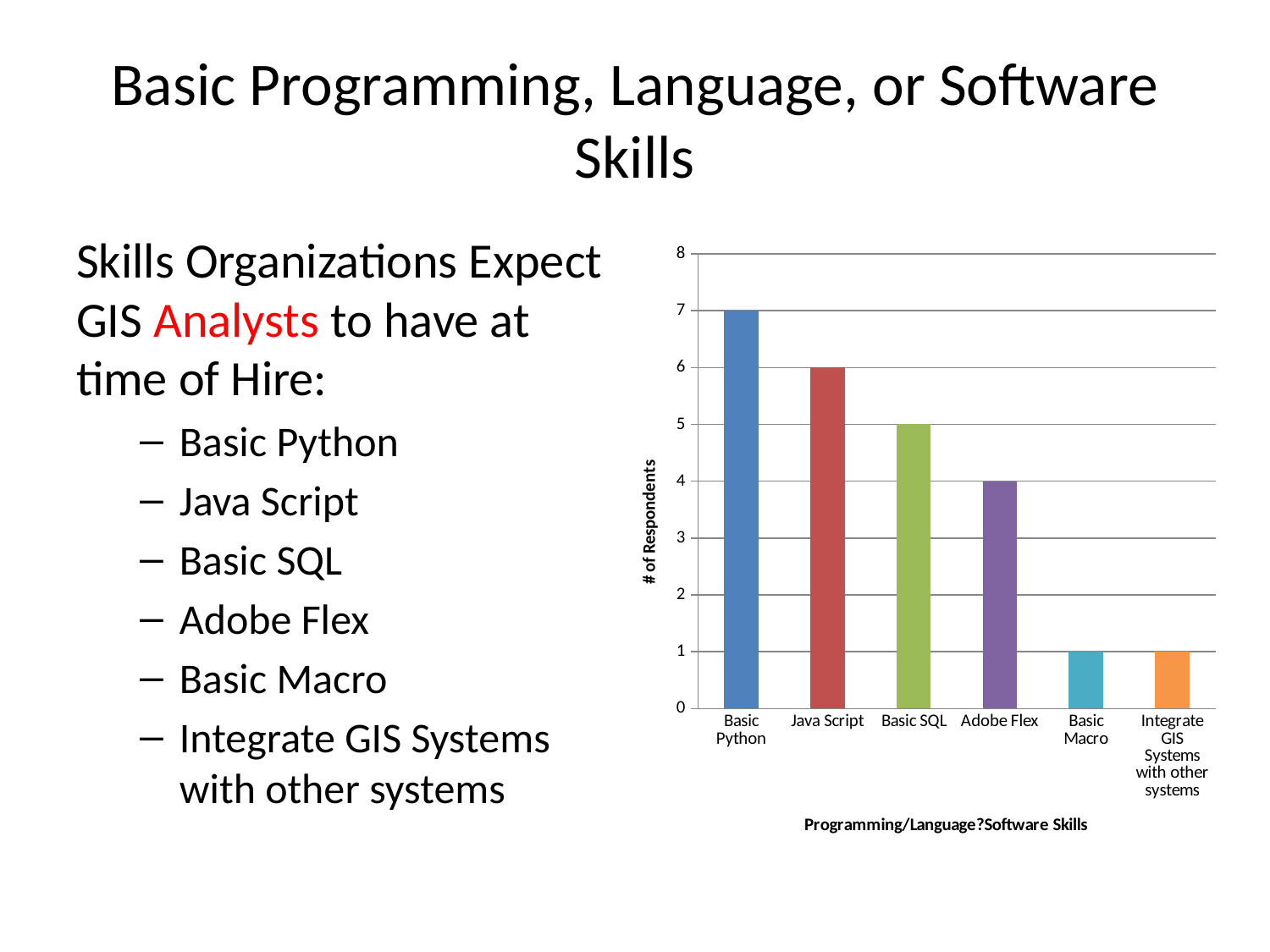
What is the number of respondents for Basic SQL? 5 What is the difference in respondents between Basic Python and Adobe Flex? 3 What is the number of respondents for Java Script? 6 What type of chart is shown on the slide? Bar chart What is the label of the vertical axis? # of Respondents Do the values rise or fall from left to right across the categories? Fall What is the number of respondents for Adobe Flex? 4 How many respondents expect Basic Python? 7 What is the number of respondents for Basic Macro? 1 How many skill categories are shown on the x axis? 6 Which has more respondents, Java Script or Basic SQL? Java Script Which skill has the highest number of respondents? Basic Python